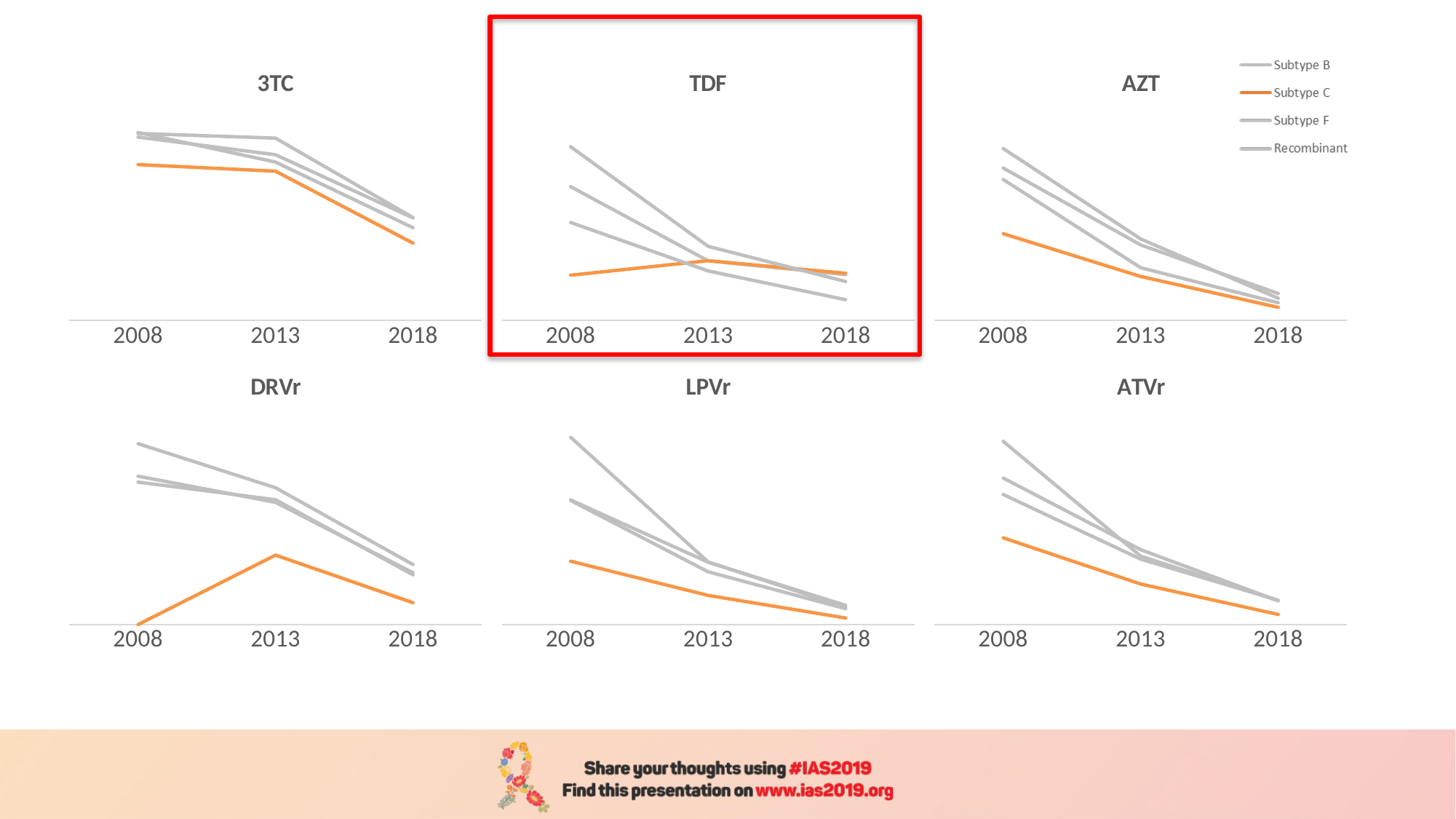
How many points are plotted along the x axis of the TDF chart? 3 Which series is drawn in orange in the legend? Subtype C Which chart on the slide is outlined with a red box? TDF In the LPVr chart, does the Subtype C line rise or fall from 2008 to 2018? fall In the DRVr chart, is the Subtype C value larger in 2008 or in 2013? 2013 In the TDF chart, is the Subtype C value larger in 2008 or in 2013? 2013 In the DRVr chart, in which year is the Subtype C value lowest? 2008 In the ATVr chart, does the Subtype C line rise or fall from 2008 to 2018? fall What kind of chart is the 3TC chart? line chart How many series does the legend list? 4 How many charts are shown on the slide? 6 In the AZT chart, does the Subtype C line rise or fall from 2008 to 2018? fall